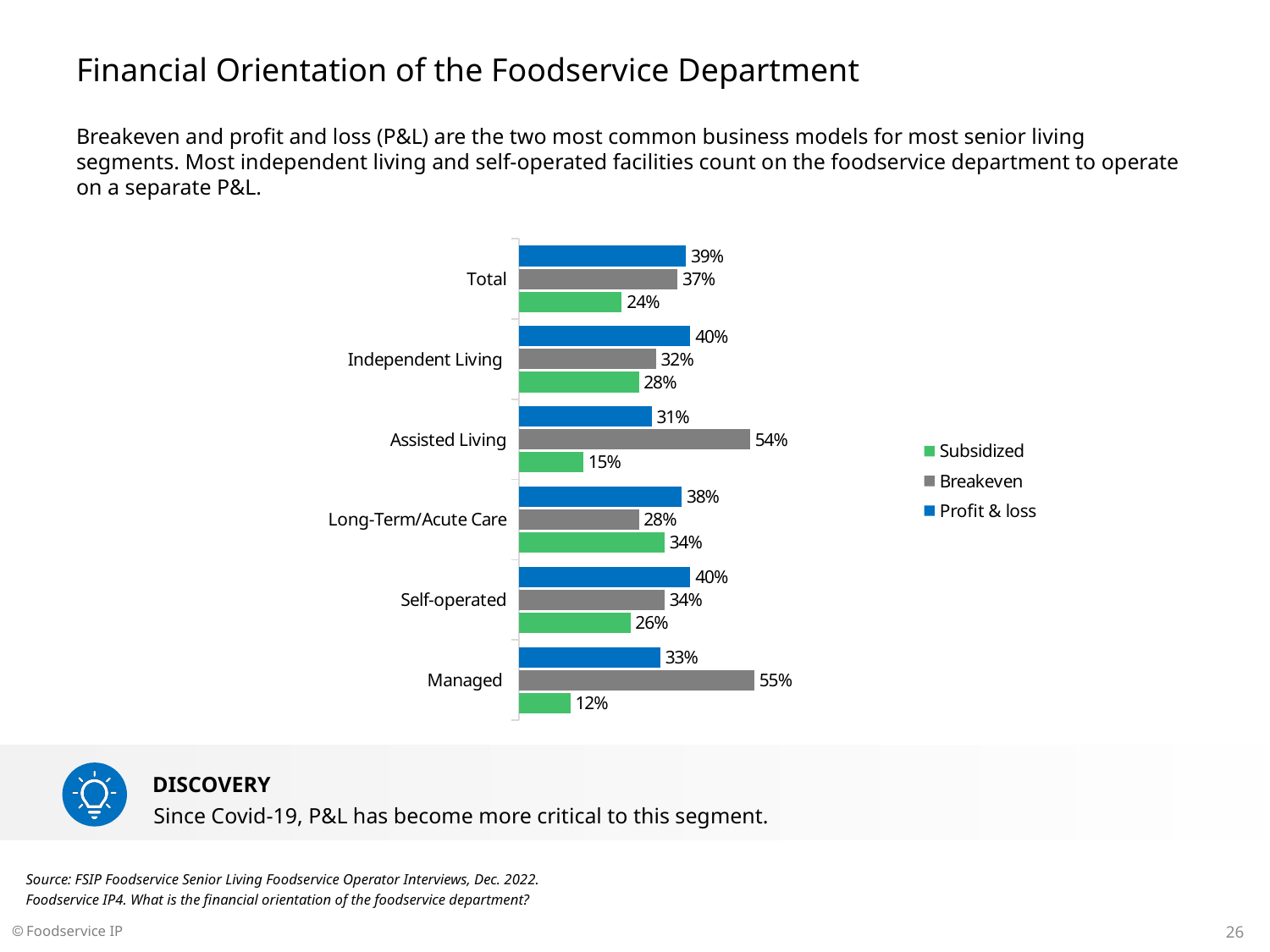
What is the Breakeven value for Assisted Living? 54% Which category has the lowest Subsidized value? Managed What is the difference between the Breakeven and Profit & loss values for Managed? 22% For Long-Term/Acute Care, which is larger: the Subsidized value or the Breakeven value? Subsidized What is the Profit & loss value for Total? 39% What kind of chart is shown on the slide? Bar chart Which series is shown in green? Subsidized How many series does the legend list? 3 What is the Subsidized value for Managed? 12% How many categories are shown on the chart? 6 Which category has the highest Breakeven value? Managed What is the Profit & loss value for Self-operated? 40%